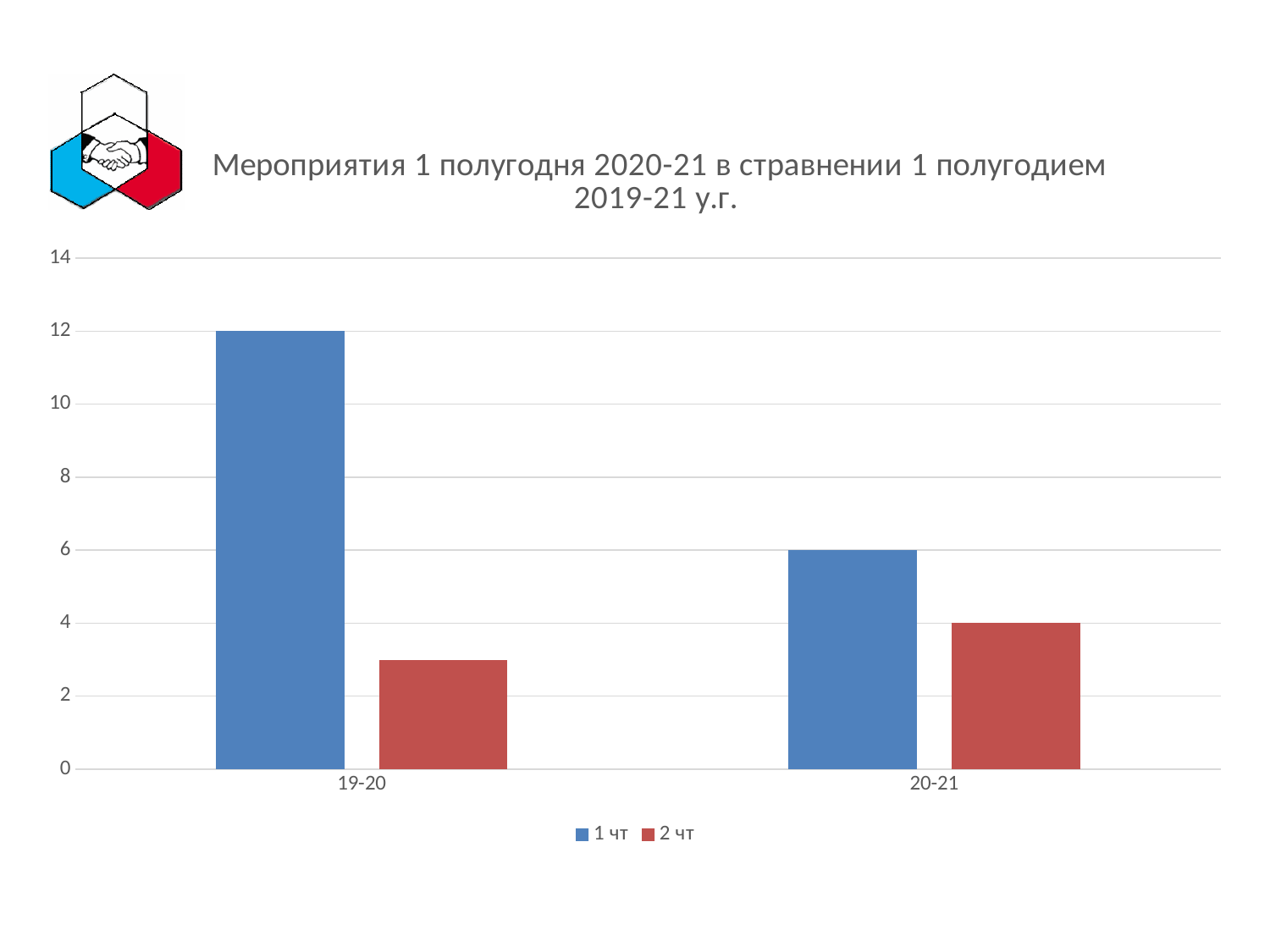
Is the value of the "2 чт" series for 19-20 greater or less than 2? greater Is the value of the "2 чт" series for 19-20 greater or less than 4? less Which bar is the lowest in the chart? 2 чт for 19-20 How many series does the legend list? 2 What is the value of the "1 чт" series for 20-21? 6 Which bar is the highest in the chart? 1 чт for 19-20 What type of chart is shown on the slide? bar chart Which is larger for 20-21: "1 чт" or "2 чт"? 1 чт What is the value of the "1 чт" series for 19-20? 12 How many categories are shown on the x axis? 2 What is the value of the "2 чт" series for 20-21? 4 What is the difference between the "1 чт" values for 19-20 and 20-21? 6